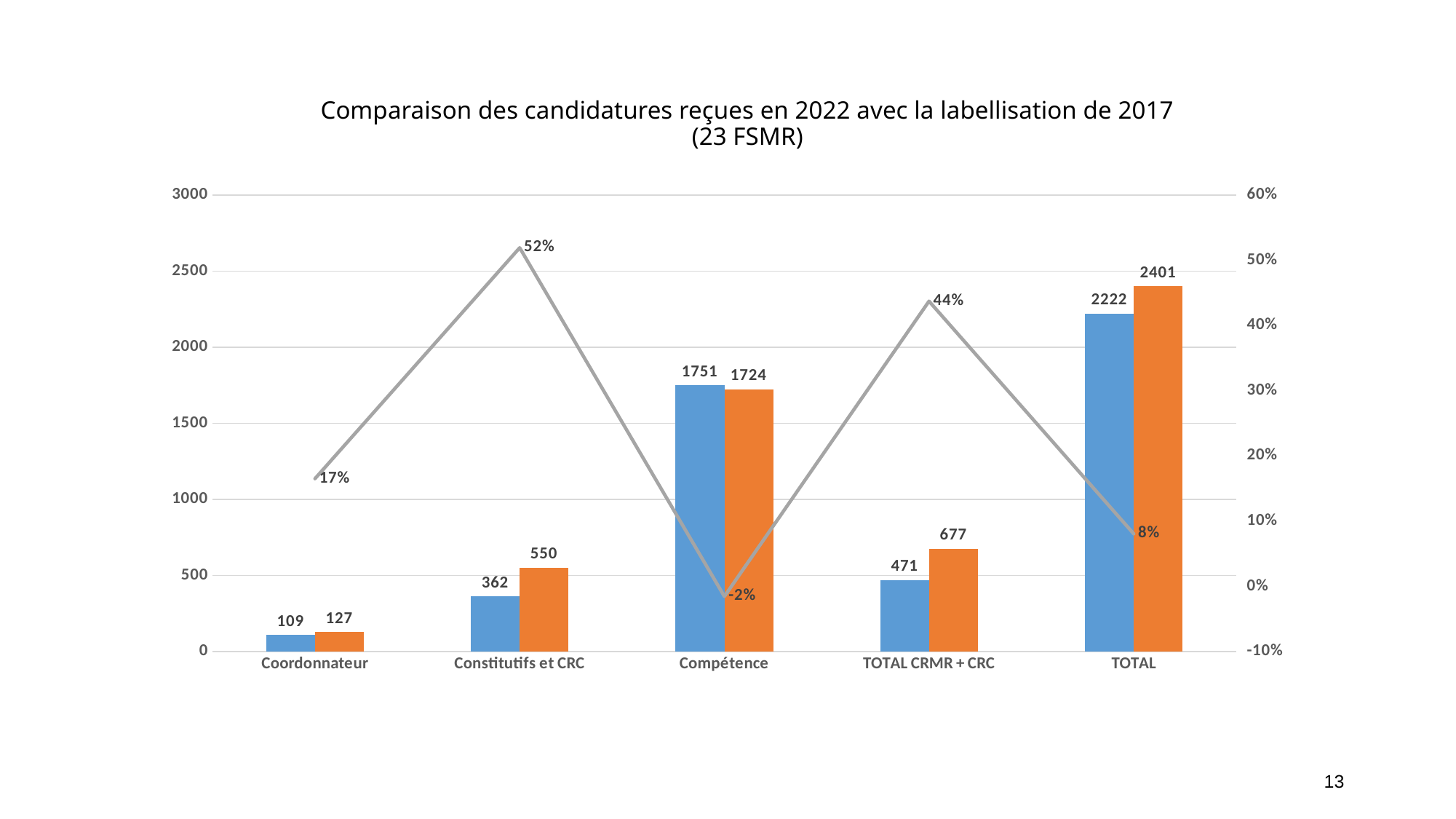
How many categories are shown on the x axis? 5 What percentage does the grey line show for Constitutifs et CRC? 52% Which category has the highest value on the grey line? Constitutifs et CRC What kind of chart is this? a combined bar and line chart For Compétence, which bar is larger, the blue bar or the orange bar? the blue bar What is the title of the chart? Comparaison des candidatures reçues en 2022 avec la labellisation de 2017 (23 FSMR) What is the value of the blue bar for Compétence? 1751 What is the value of the blue bar for Constitutifs et CRC? 362 What percentage does the grey line show for Compétence? -2% What is the difference between the orange bar and the blue bar for TOTAL CRMR + CRC? 206 Which category has the lowest blue bar? Coordonnateur What is the value of the orange bar for TOTAL? 2401